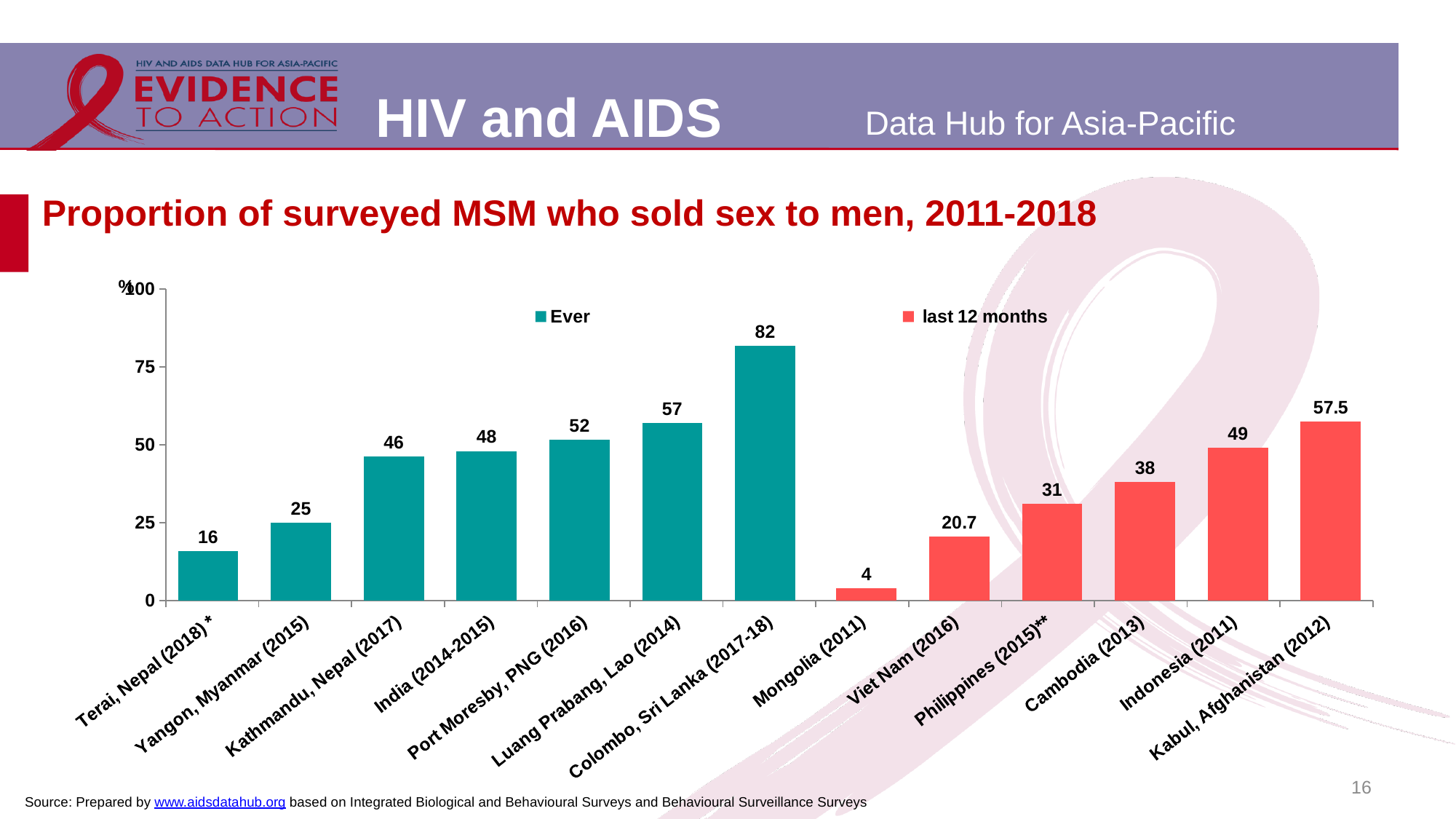
Which series is shown in red in the legend? last 12 months What kind of chart is shown on the slide? bar chart What is the difference between the values for Luang Prabang, Lao (2014) and Terai, Nepal (2018)*? 41 What is the value for Colombo, Sri Lanka (2017-18)? 82 What is the value for Viet Nam (2016)? 20.7 What is the value for Kabul, Afghanistan (2012)? 57.5 How many series does the legend list? 2 Which category has the highest value in the chart? Colombo, Sri Lanka (2017-18) How many categories are shown on the x axis? 13 Which category has the lowest value in the chart? Mongolia (2011) Is the value for Philippines (2015)** greater or less than 25? greater Which is larger: the value for Indonesia (2011) or the value for Cambodia (2013)? Indonesia (2011)